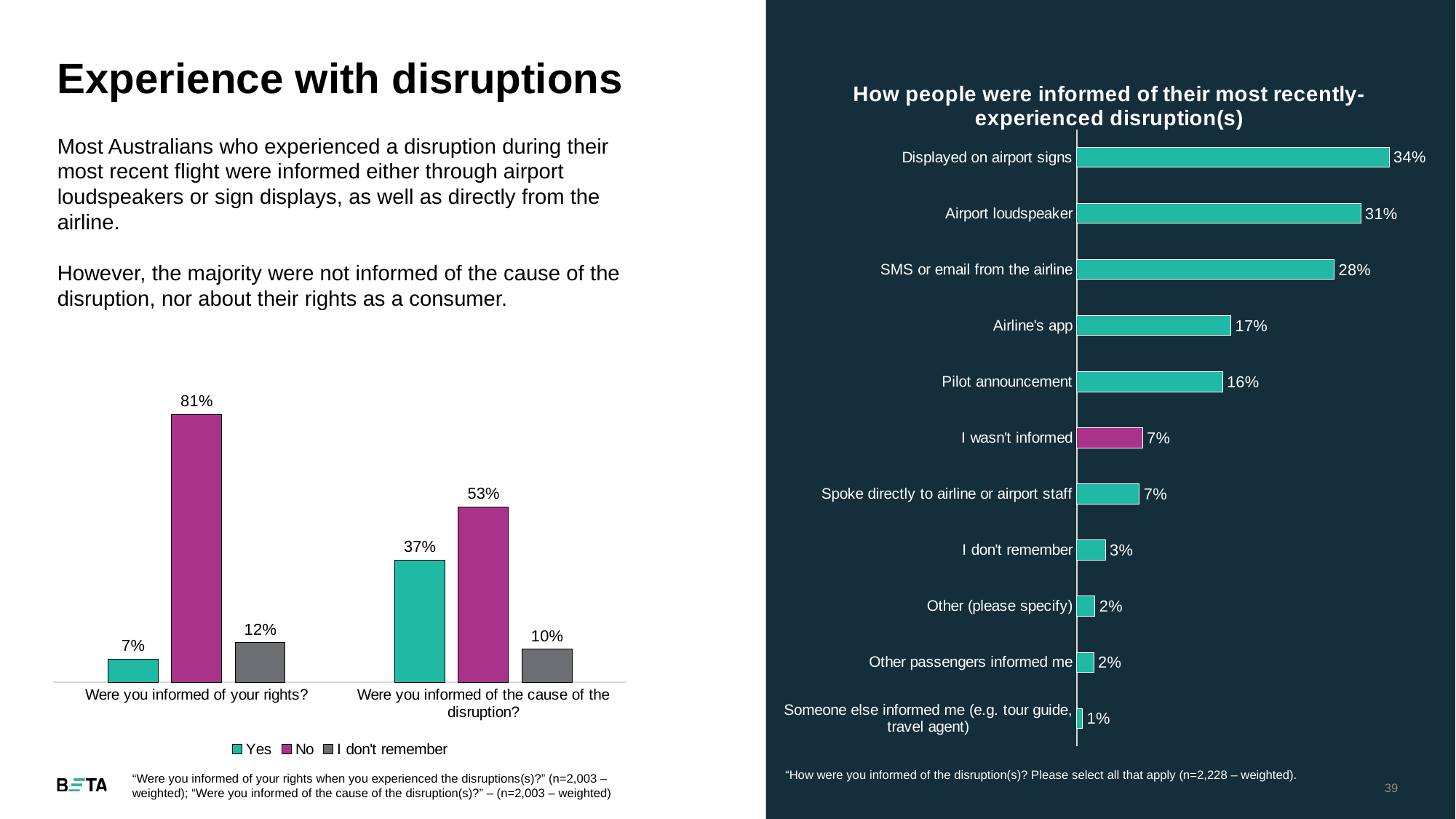
In the bar chart on the left of the slide, what is the 'No' value for 'Were you informed of your rights?'? 81% In the chart titled 'How people were informed of their most recently-experienced disruption(s)', what is the difference between 'Airport loudspeaker' and 'SMS or email from the airline'? 3% What kind of chart is the chart on the left of the slide? Bar chart In the bar chart on the left of the slide, what is the difference between the 'No' values for 'Were you informed of your rights?' and 'Were you informed of the cause of the disruption?'? 28% In the chart titled 'How people were informed of their most recently-experienced disruption(s)', what is the value for 'Displayed on airport signs'? 34% In the chart titled 'How people were informed of their most recently-experienced disruption(s)', how many categories are shown? 11 In the chart titled 'How people were informed of their most recently-experienced disruption(s)', which category has the highest value? Displayed on airport signs In the chart titled 'How people were informed of their most recently-experienced disruption(s)', what is the value for 'Pilot announcement'? 16% In the bar chart on the left of the slide, how many series does the legend list? 3 In the chart titled 'How people were informed of their most recently-experienced disruption(s)', which category has the lowest value? Someone else informed me (e.g. tour guide, travel agent) In the bar chart on the left of the slide, what is the 'Yes' value for 'Were you informed of the cause of the disruption?'? 37% In the chart titled 'How people were informed of their most recently-experienced disruption(s)', which bar is shown in a different colour (magenta) from the others? I wasn't informed